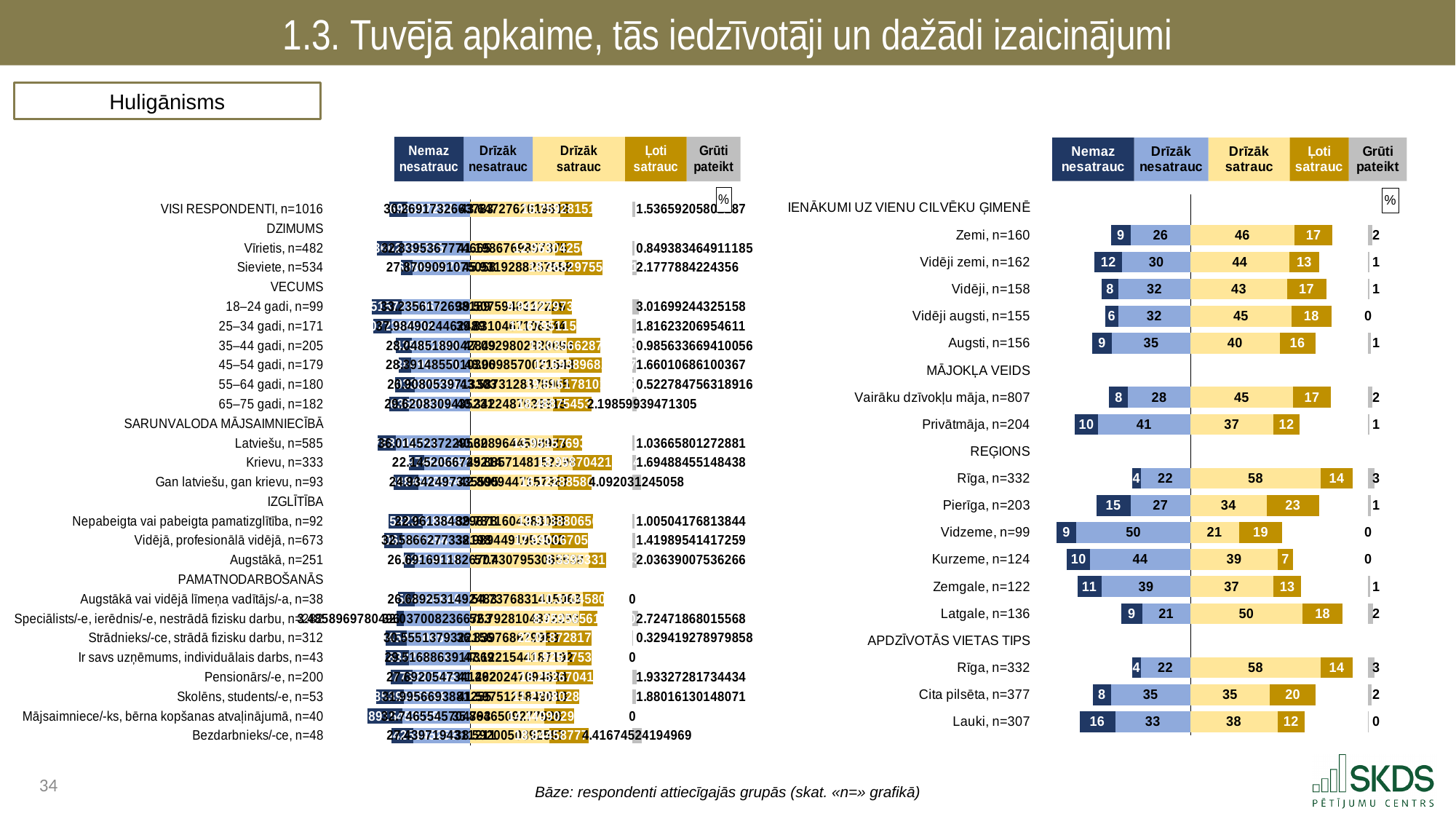
In the right chart, how many categories are shown under the IENĀKUMI UZ VIENU CILVĒKU ĢIMENĒ group? 5 How many series does the legend of the right chart list? 5 In the right chart, what is the difference between the 'Ļoti satrauc' values for Cita pilsēta, n=377 and Lauki, n=307? 8 In the right chart, what is the 'Drīzāk nesatrauc' value for Privātmāja, n=204? 41 In the right chart, what is the 'Drīzāk satrauc' value for Rīga, n=332 under REĢIONS? 58 In the right chart, what is the difference between the 'Drīzāk satrauc' values for Rīga, n=332 and Vidzeme, n=99 under REĢIONS? 37 In the right chart, which has a larger 'Drīzāk nesatrauc' value: Augsti, n=156 or Zemi, n=160? Augsti, n=156 In the right chart, which region under REĢIONS has the lowest 'Ļoti satrauc' value? Kurzeme, n=124 In the right chart, what is the 'Ļoti satrauc' value for Pierīga, n=203? 23 In the right chart, what is the 'Nemaz nesatrauc' value for Lauki, n=307? 16 What kind of chart is the right chart? Stacked bar chart In the right chart, which region under REĢIONS has the highest 'Drīzāk nesatrauc' value? Vidzeme, n=99